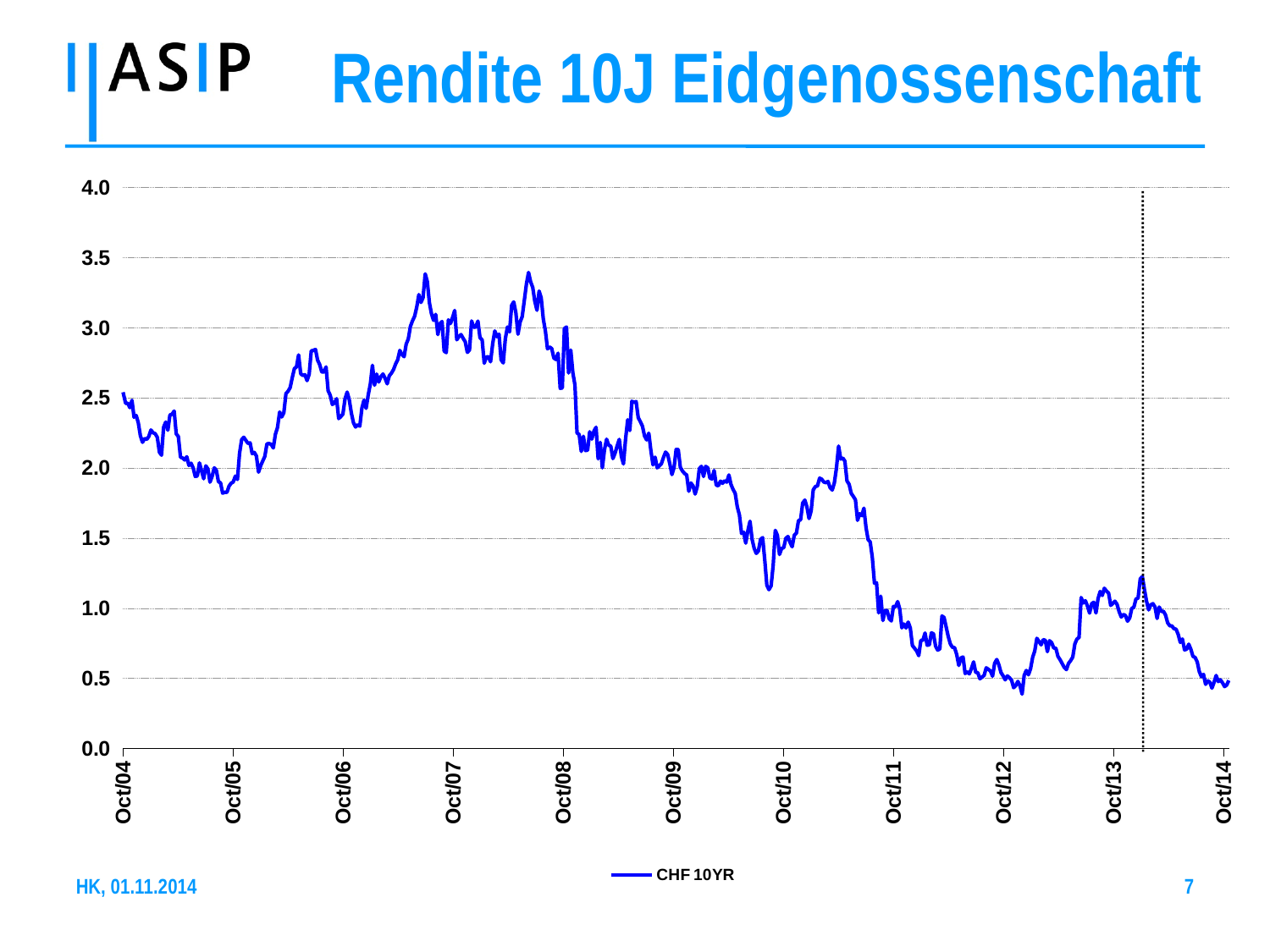
How many series does the legend list? 1 Is the value for CHF 10YR at Oct/06 greater or less than 2.0? greater Is the value for CHF 10YR at Oct/14 greater or less than the value at Oct/04? less What is the name of the series shown in the legend? CHF 10YR What is the title of the chart? Rendite 10J Eidgenossenschaft Is the value for CHF 10YR at Oct/14 greater or less than 1.0? less What kind of chart is shown on the slide? line chart How many date labels are shown on the x axis? 11 Does the CHF 10YR line ever rise above 3.5? no What is the highest value shown on the y axis? 4.0 Overall, does the CHF 10YR line rise or fall from Oct/04 to Oct/14? fall